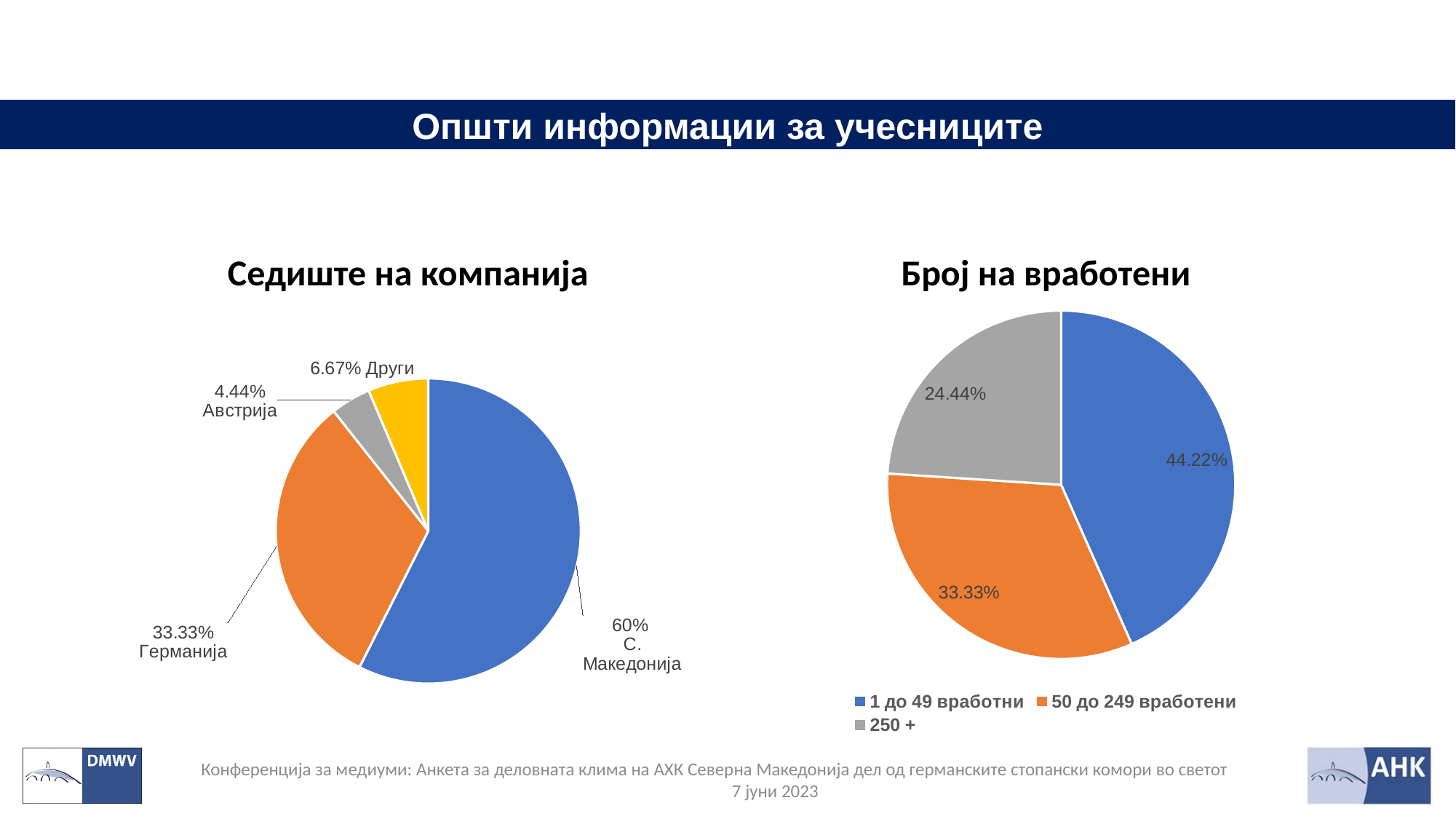
In the chart titled "Број на вработени", which category has the largest slice? 1 до 49 вработни What type of chart is the chart titled "Број на вработени"? Pie chart In the chart titled "Седиште на компанија", what is the value for Австрија? 4.44% In the chart titled "Број на вработени", what is the value for 250 +? 24.44% In the chart titled "Седиште на компанија", what is the difference between the shares for С. Македонија and Германија? 26.67% In the chart titled "Седиште на компанија", how many slices does the pie have? 4 In the chart titled "Број на вработени", which is larger: 50 до 249 вработени or 250 +? 50 до 249 вработени In the chart titled "Број на вработени", how many entries does the legend list? 3 In the chart titled "Седиште на компанија", what share of companies have their headquarters in С. Македонија? 60% In the chart titled "Број на вработени", what is the value for 1 до 49 вработни? 44.22% In the chart titled "Седиште на компанија", what is the value for Германија? 33.33% In the chart titled "Седиште на компанија", which category has the smallest slice? Австрија